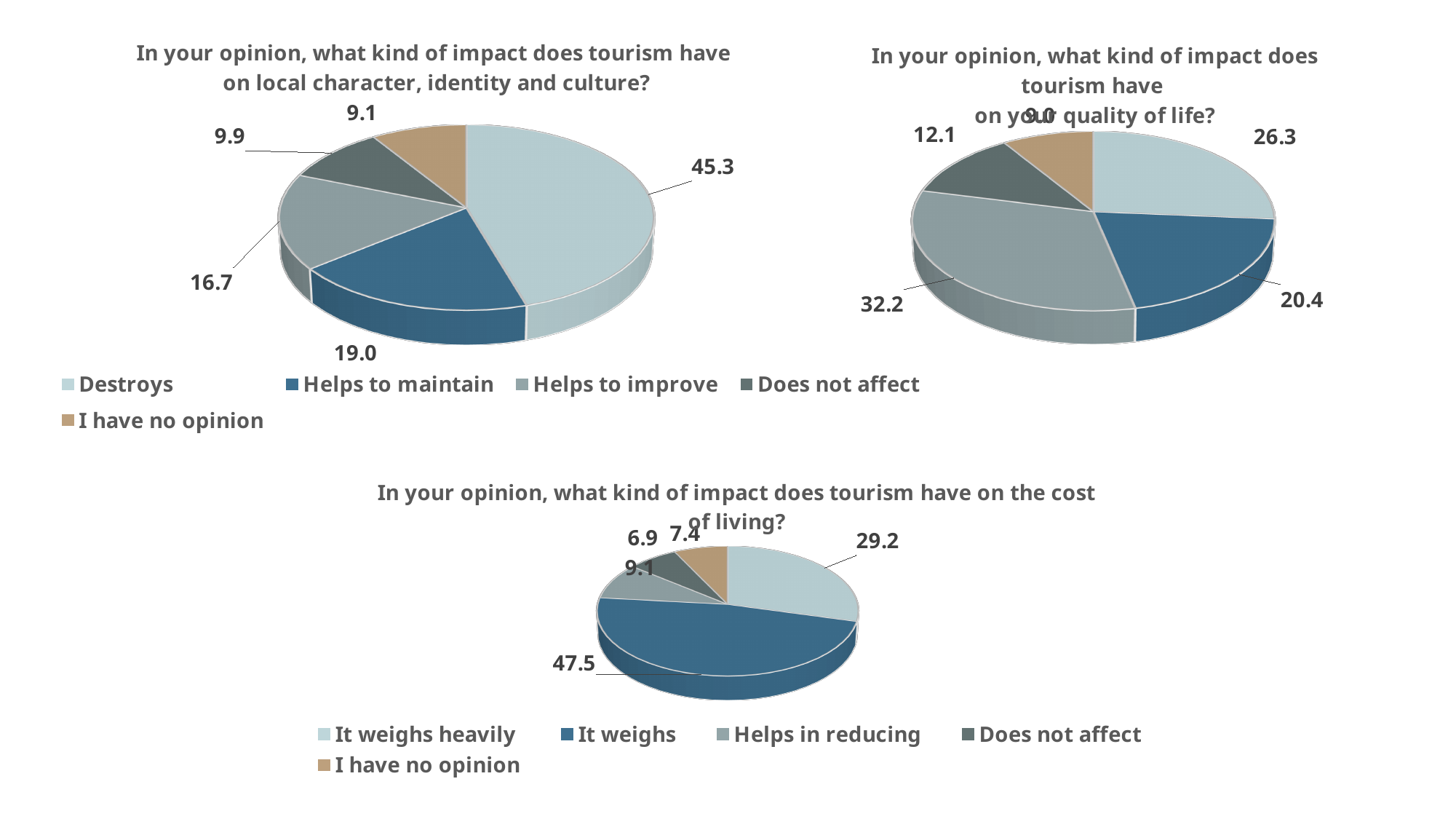
In the chart titled "In your opinion, what kind of impact does tourism have on local character, identity and culture?", what is the value for "Destroys"? 45.3 In the chart titled "In your opinion, what kind of impact does tourism have on local character, identity and culture?", how many categories does the legend list? 5 In the chart titled "In your opinion, what kind of impact does tourism have on local character, identity and culture?", which category has the smallest slice? I have no opinion In the chart titled "In your opinion, what kind of impact does tourism have on your quality of life?", what is the value of the dark blue slice? 20.4 What type of chart is used for the chart titled "In your opinion, what kind of impact does tourism have on the cost of living?"? Pie chart In the chart titled "In your opinion, what kind of impact does tourism have on local character, identity and culture?", which category has the largest slice? Destroys In the chart titled "In your opinion, what kind of impact does tourism have on the cost of living?", what is the difference between "It weighs" and "It weighs heavily"? 18.3 In the chart titled "In your opinion, what kind of impact does tourism have on your quality of life?", what is the value of the largest slice? 32.2 In the chart titled "In your opinion, what kind of impact does tourism have on local character, identity and culture?", what is the difference between "Helps to maintain" and "Does not affect"? 9.1 In the chart titled "In your opinion, what kind of impact does tourism have on local character, identity and culture?", what is the value for "Helps to improve"? 16.7 In the chart titled "In your opinion, what kind of impact does tourism have on the cost of living?", what is the value for "It weighs"? 47.5 In the chart titled "In your opinion, what kind of impact does tourism have on the cost of living?", which is larger, "Helps in reducing" or "Does not affect"? Helps in reducing